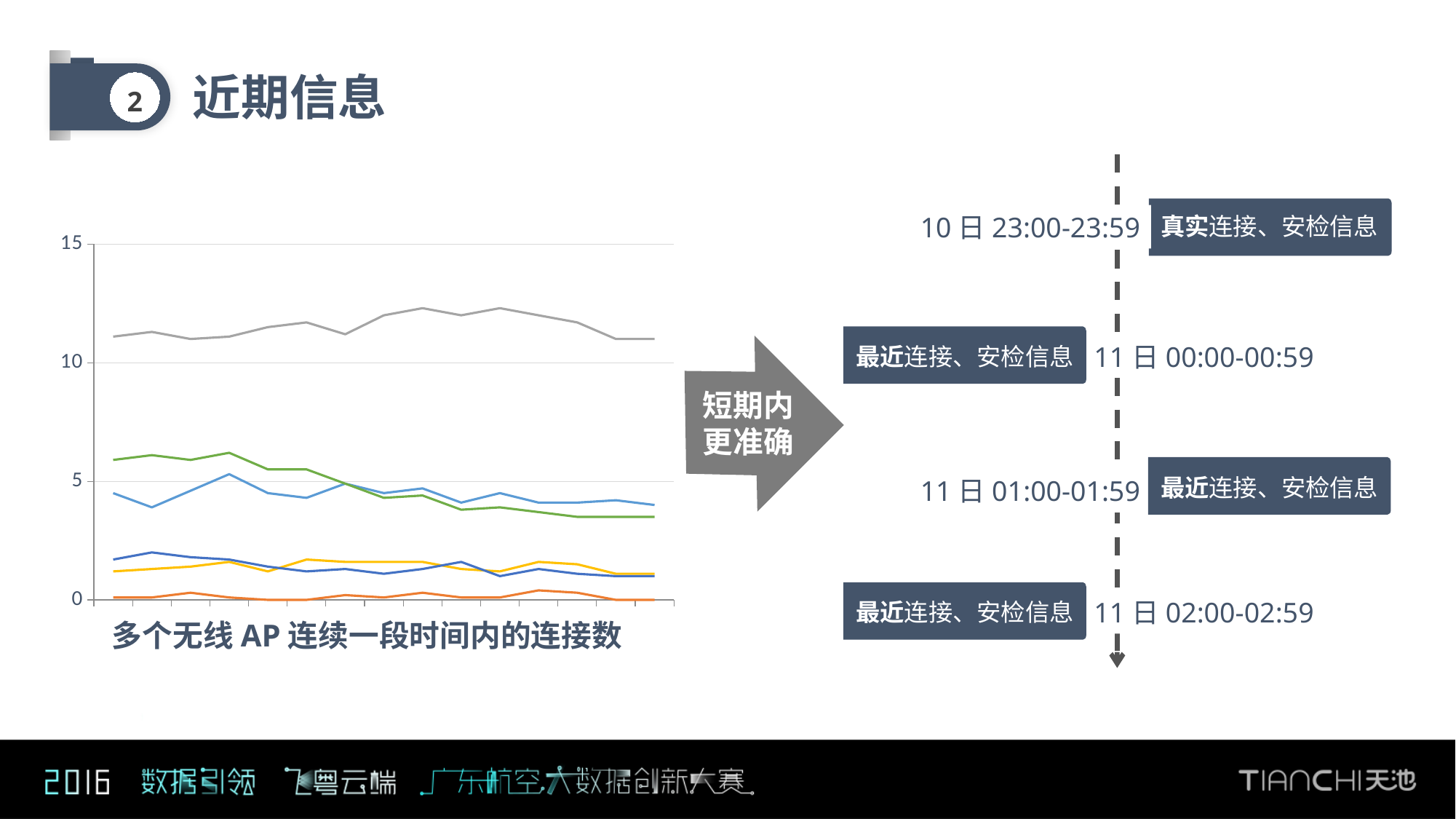
Are the values of the gray line greater or less than 10? greater Which line has larger values, the gray line or the green line? the gray line How many lines are plotted on the chart? 6 Are the values of the orange line greater or less than 5? less What is the highest value shown on the chart's vertical axis? 15 Are the values of the green line greater or less than 10? less Which coloured line has the highest values throughout the chart? the gray line What kind of chart is shown on the left of the slide? line chart What is the caption printed below the chart? 多个无线 AP 连续一段时间内的连接数 Which line has larger values, the light blue line or the orange line? the light blue line Does the green line rise or fall overall from left to right? fall Which coloured line has the lowest values throughout the chart? the orange line